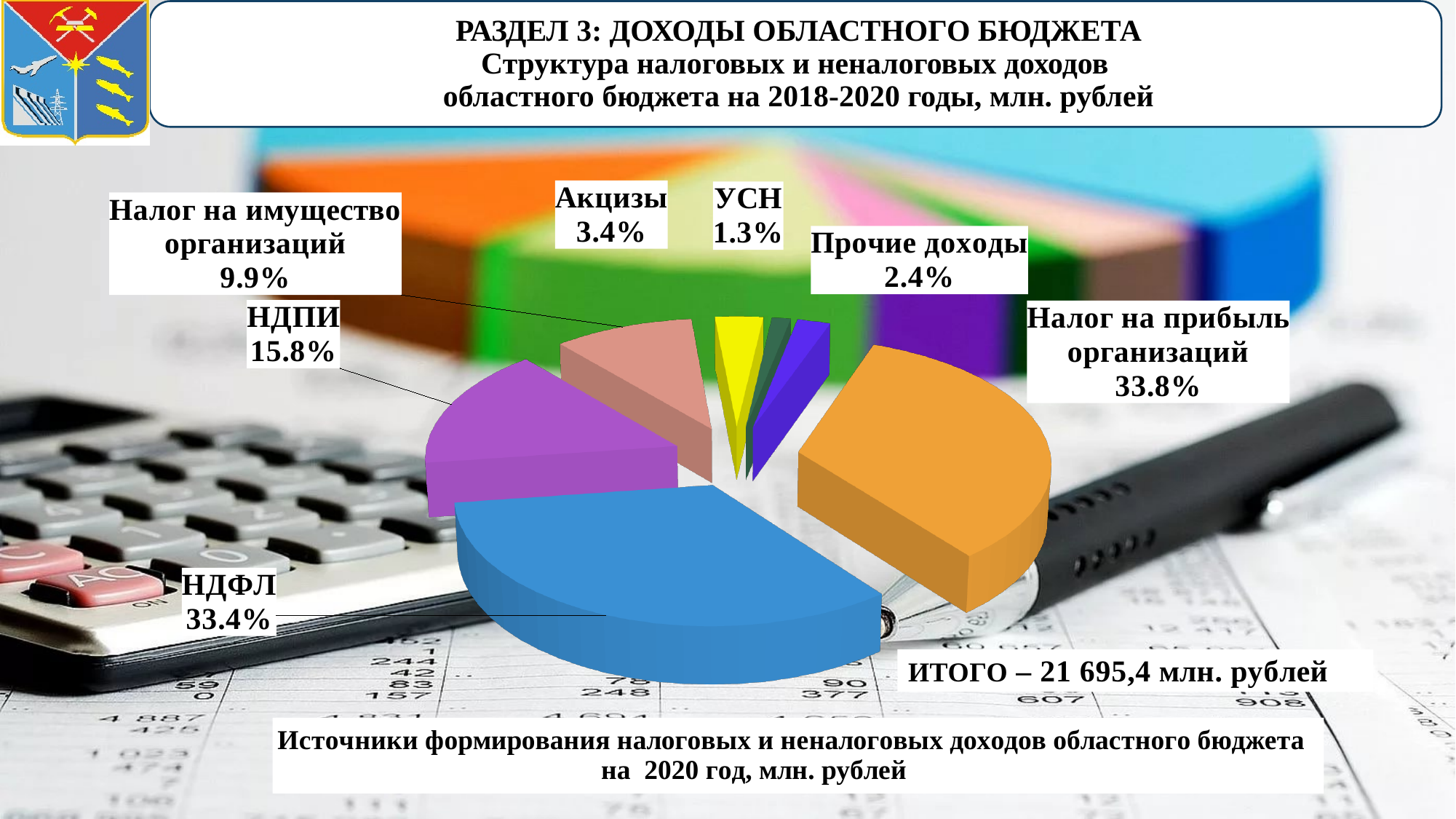
What percentage is shown for Налог на прибыль организаций? 33.8% What percentage is shown for НДПИ? 15.8% Which is larger: the share for НДПИ or the share for Налог на имущество организаций? НДПИ What percentage is shown for Акцизы? 3.4% What is the difference in percentage points between Налог на имущество организаций and Акцизы? 6.5 Which category has the largest share in the pie chart? Налог на прибыль организаций How many categories (slices) are labelled in the pie chart? 7 What kind of chart is shown on the slide? pie chart Which category has the smallest share in the pie chart? УСН What total (ИТОГО) is stated on the slide for the revenues? 21 695,4 млн. рублей What percentage is shown for Прочие доходы? 2.4% What share of the pie chart is labelled for НДФЛ? 33.4%